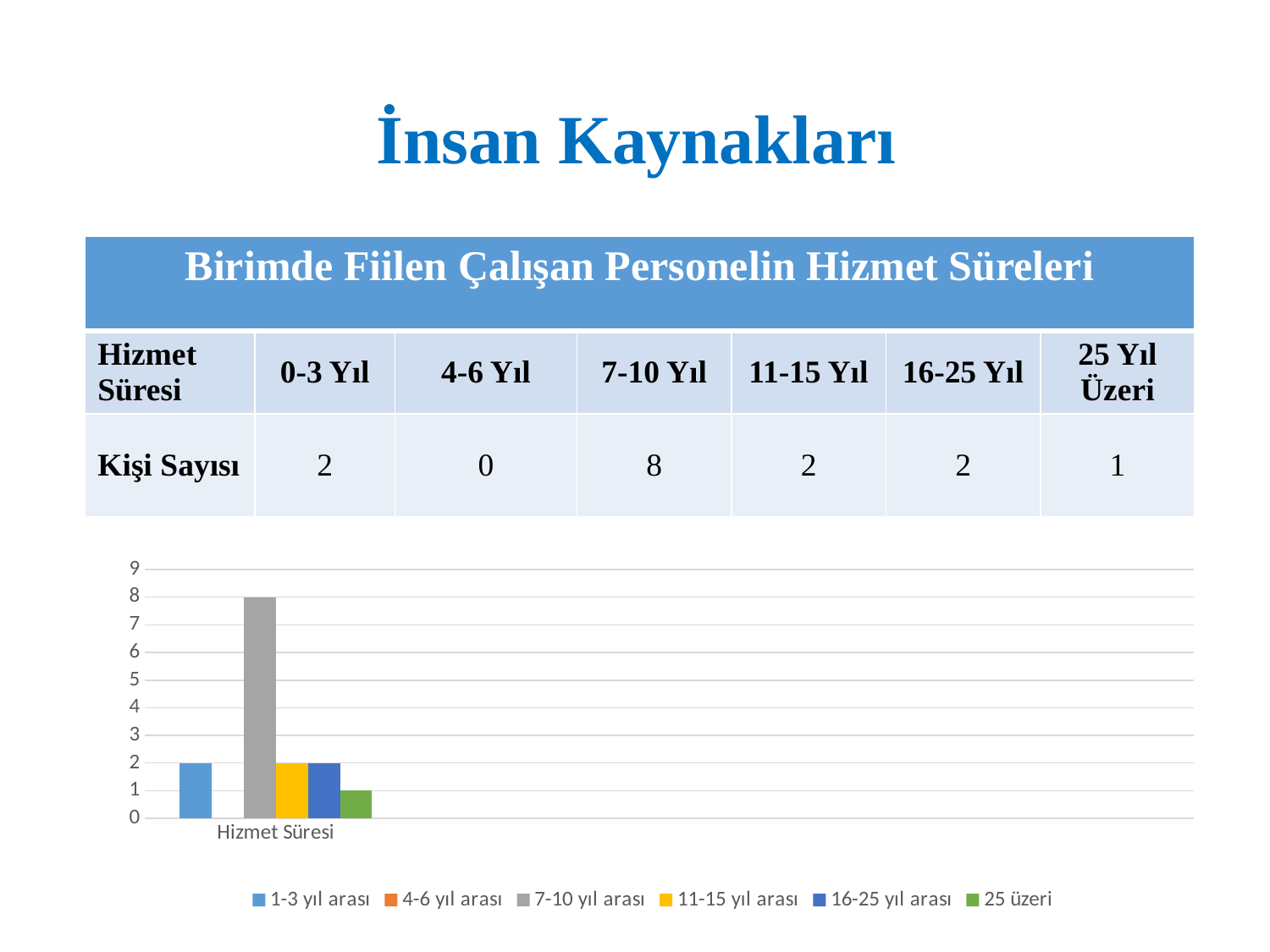
What is the value of the 25 üzeri bar in the chart? 1 What is the category label shown on the x axis of the chart? Hizmet Süresi Which series has the highest bar in the chart? 7-10 yıl arası Is the value of the 7-10 yıl arası bar greater or less than 5? greater What colour is the 7-10 yıl arası bar in the chart? grey What is the value of the 7-10 yıl arası bar in the chart? 8 What is the value of the 1-3 yıl arası bar in the chart? 2 Which is larger in the chart, the 11-15 yıl arası bar or the 25 üzeri bar? 11-15 yıl arası How many series does the chart legend list? 6 What is the difference between the 7-10 yıl arası bar and the 16-25 yıl arası bar? 6 What kind of chart is shown on the slide? bar chart Which series has no visible bar in the chart (value 0)? 4-6 yıl arası